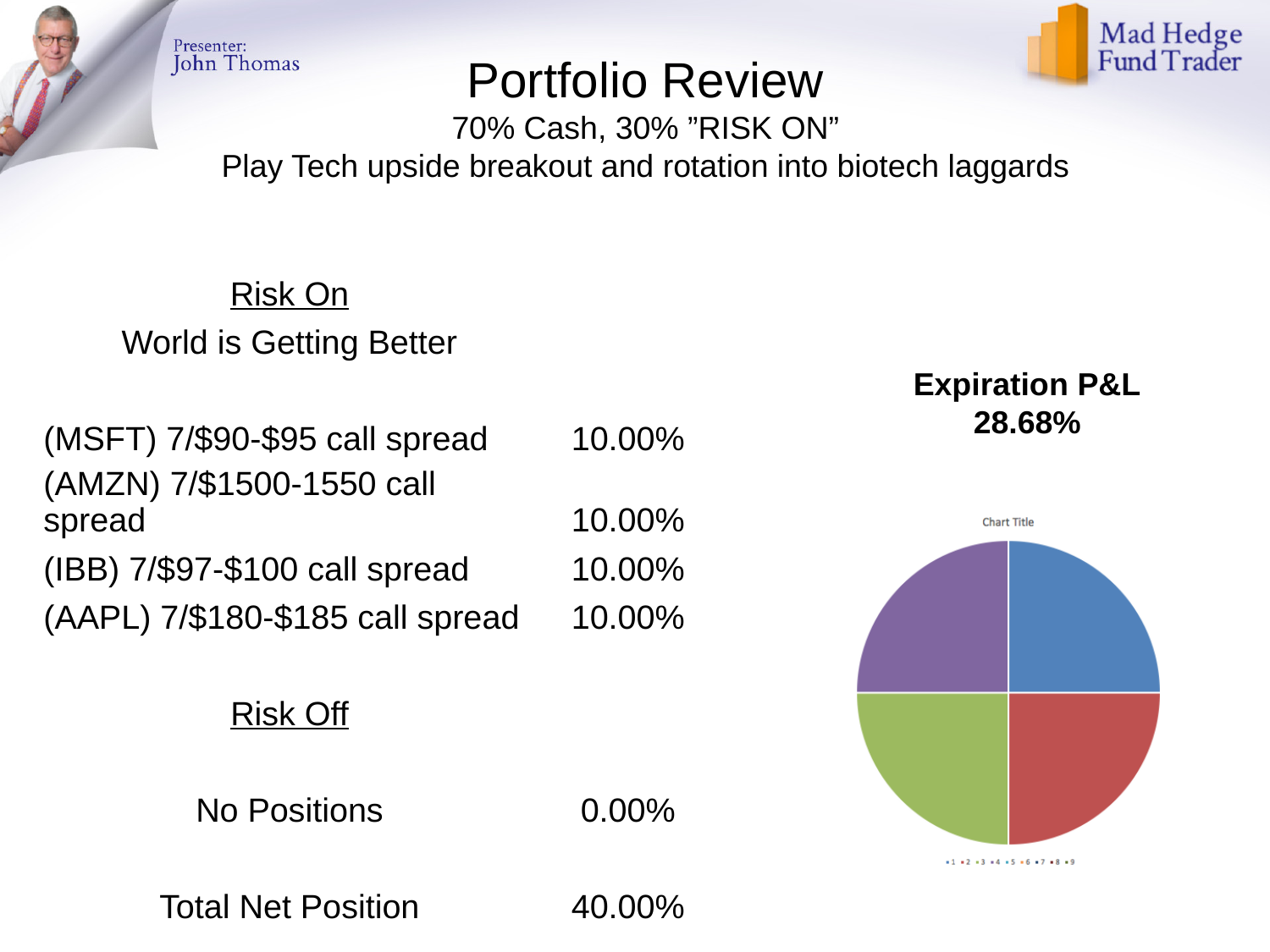
Are the four slices of the pie chart roughly equal in size? yes How many entries does the legend below the pie chart list? 9 How many slices does the pie chart contain? 4 What colour is the top-right slice of the pie chart? blue What kind of chart is shown on the right side of the slide? pie chart What title is printed above the pie chart? Chart Title